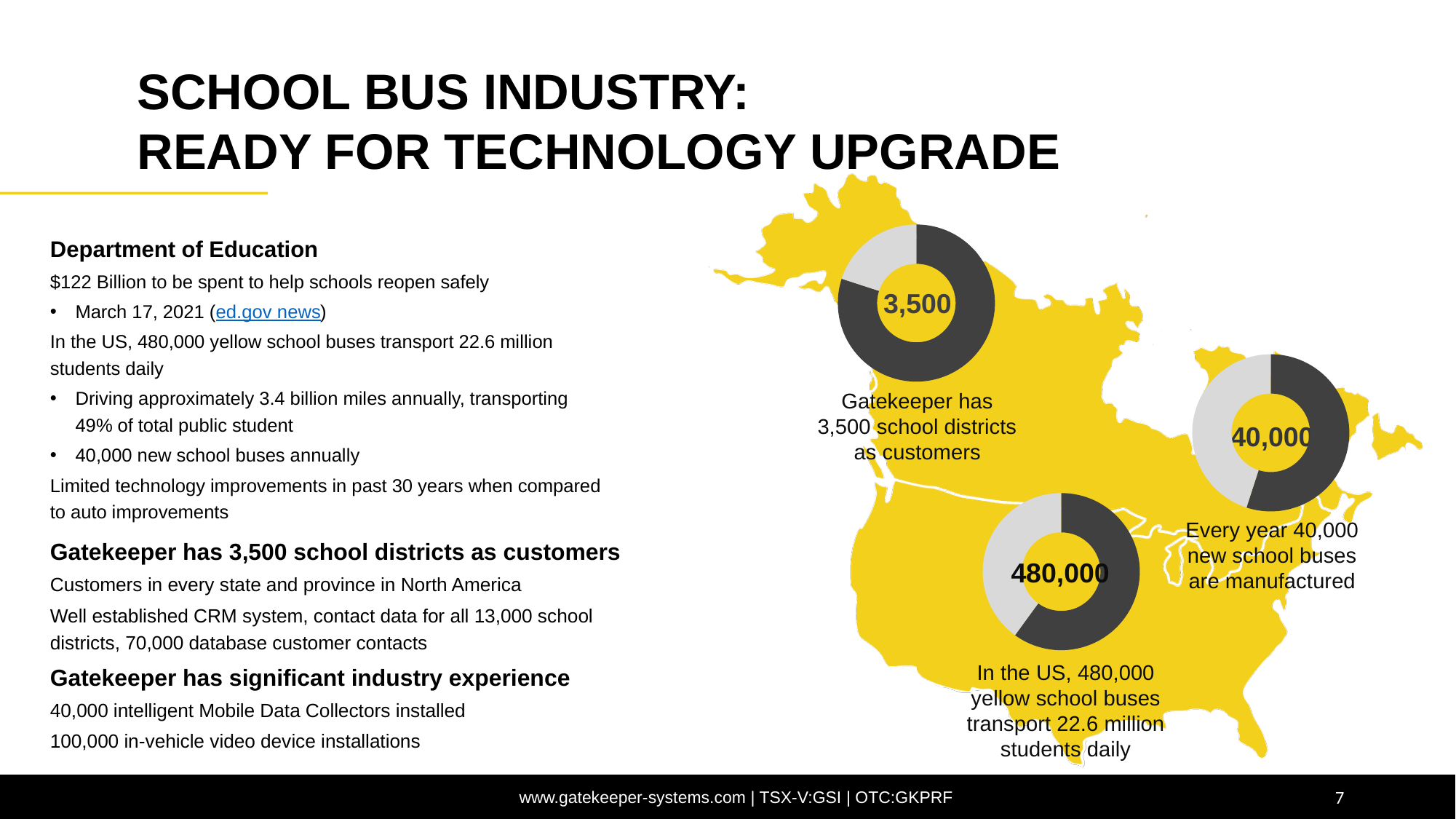
What number is shown in the centre of the donut chart on the right side of the map? 40,000 Which of the three donut charts shows the smallest central number? 3,500 What number is shown in the centre of the donut chart at the bottom of the map? 480,000 Which of the three donut charts shows the largest central number? 480,000 What kind of chart is used for the three figures overlaid on the map? Donut (pie) chart How many donut charts are shown on the map? 3 What does the caption under the 3,500 donut chart say the number represents? Gatekeeper has 3,500 school districts as customers According to the caption beside the 40,000 donut chart, what does 40,000 represent? New school buses manufactured every year Which is larger, the number in the top-left donut chart or the number in the right-hand donut chart? 40,000 What number is shown in the centre of the donut chart at the top left of the map? 3,500 In the donut chart labelled 480,000, which segment is larger, the dark one or the light grey one? The dark one